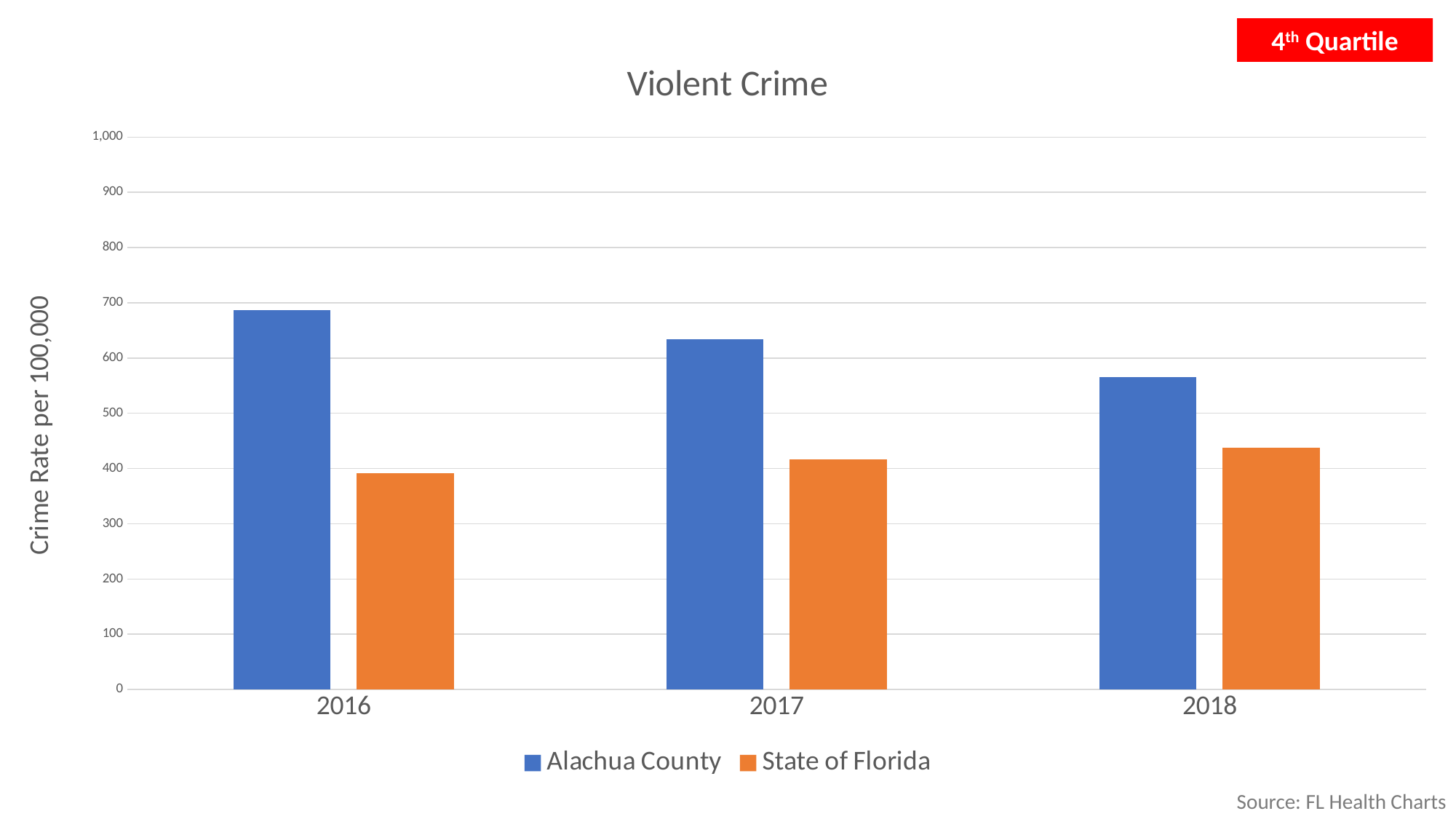
How many series does the legend list? 2 Which year has the highest value for Alachua County? 2016 In 2017, which is larger: Alachua County or State of Florida? Alachua County Do the State of Florida values rise or fall from 2016 to 2018? rise What is the title of the chart? Violent Crime Is the value for State of Florida in 2018 greater or less than 500? less Which year has the lowest value for Alachua County? 2018 Is the value for Alachua County in 2016 greater or less than 600? greater How many years are shown on the x axis? 3 What kind of chart is shown on the slide? bar chart Do the Alachua County values rise or fall from 2016 to 2018? fall Which year has the lowest value for State of Florida? 2016